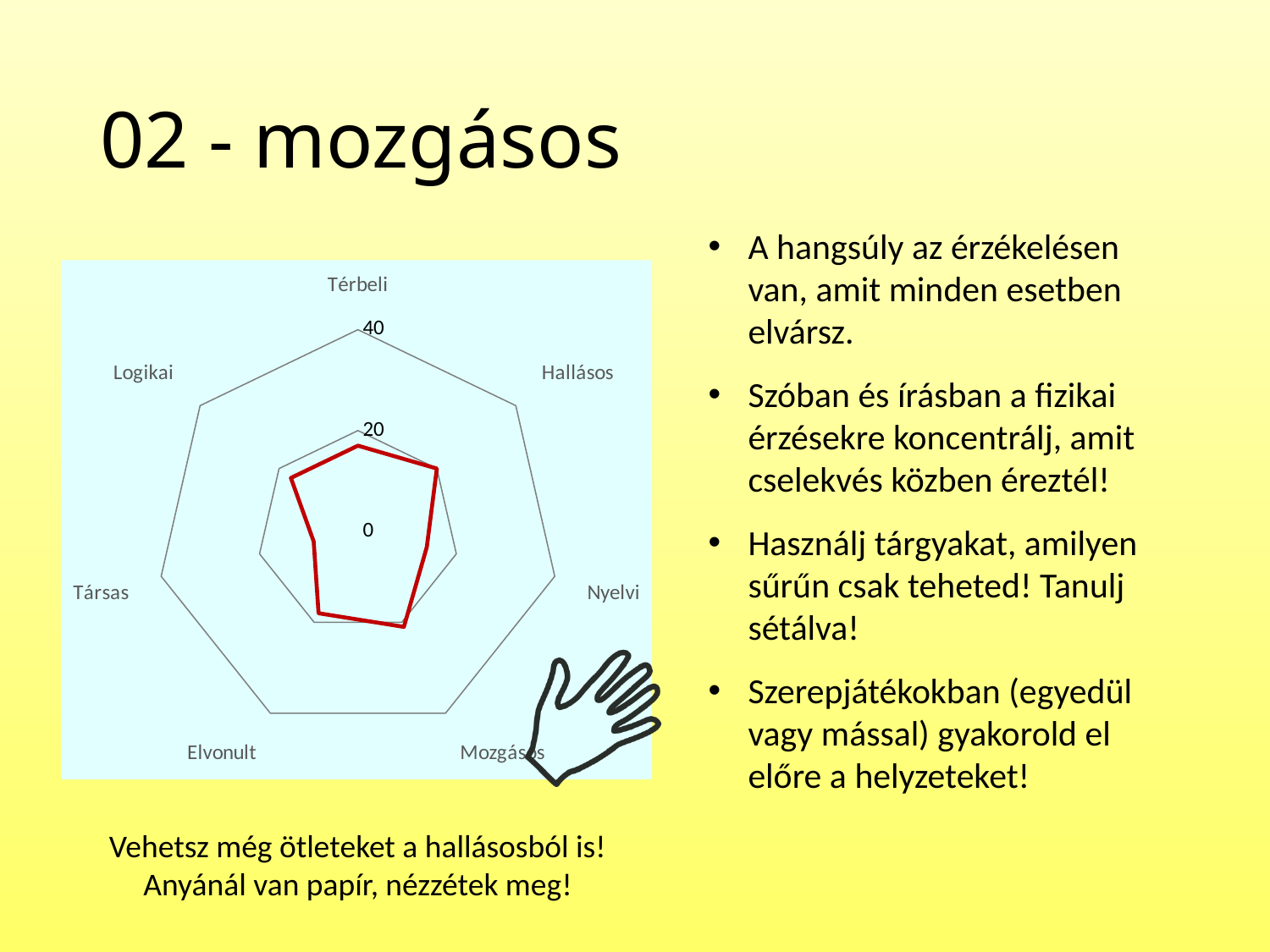
How many categories does the radar chart have? 7 What is the highest value shown on the radar chart's axis scale? 40 Which category label appears at the top of the radar chart? Térbeli What kind of chart is shown on the slide? radar chart Is the value for Nyelvi greater or less than 40? less Is the value for Elvonult greater or less than 40? less Is the value for Társas greater or less than 20? less